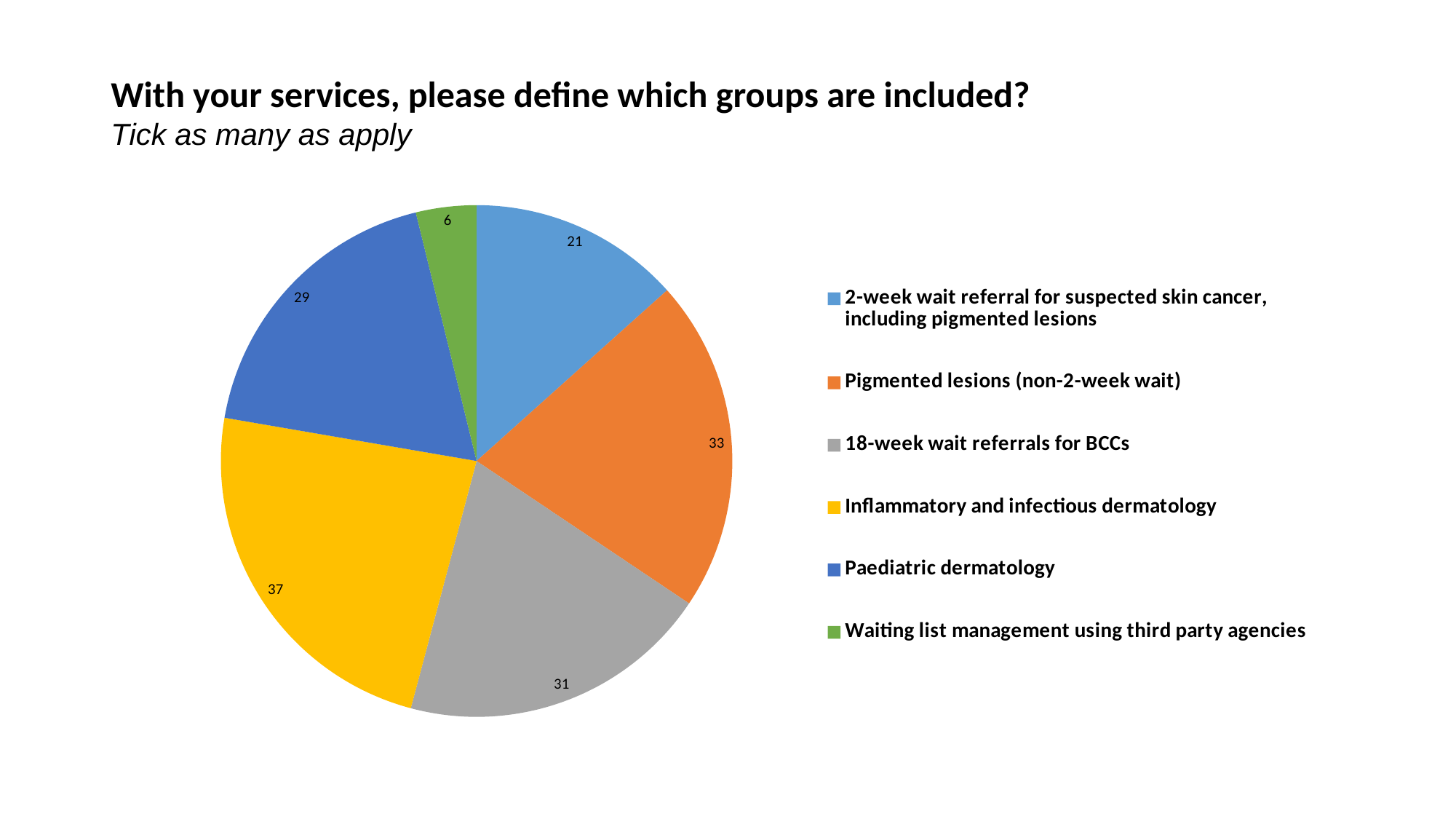
What type of chart is shown on the slide? pie chart What is the total of all the values shown in the pie chart? 157 Which is larger: the value for 18-week wait referrals for BCCs or the value for Paediatric dermatology? 18-week wait referrals for BCCs Which group has the largest slice of the pie? Inflammatory and infectious dermatology What is the value for Inflammatory and infectious dermatology? 37 What is the value for Paediatric dermatology? 29 What is the difference between the values for Inflammatory and infectious dermatology and 2-week wait referral for suspected skin cancer, including pigmented lesions? 16 What colour is the slice for 18-week wait referrals for BCCs? grey What is the value for Waiting list management using third party agencies? 6 What is the value for Pigmented lesions (non-2-week wait)? 33 How many slices does the pie chart have? 6 Which group has the smallest slice of the pie? Waiting list management using third party agencies